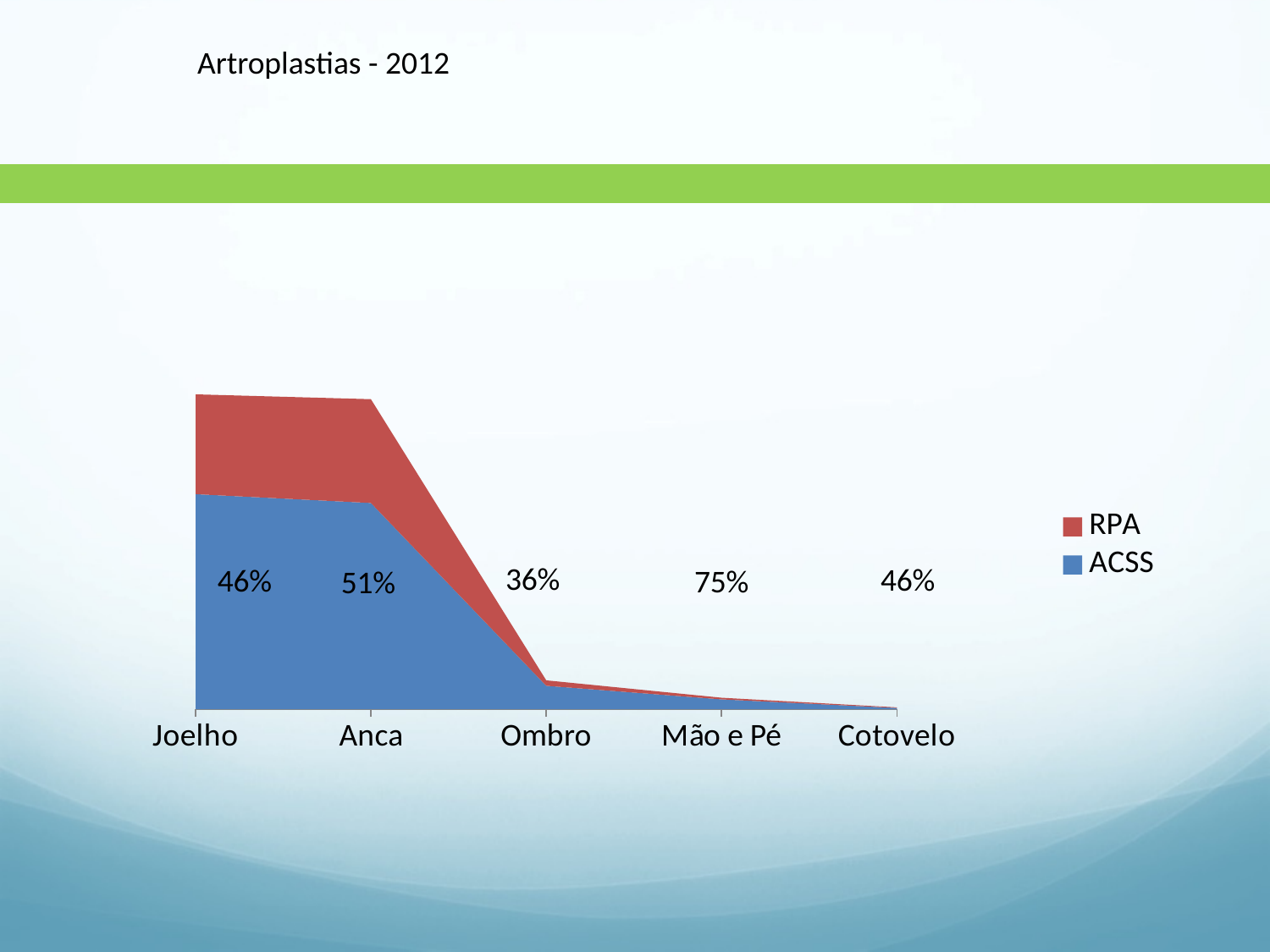
What percentage label is printed at the Ombro category? 36% How many series does the legend list? 2 Which category has the lowest stacked total? Cotovelo What percentage label is printed at the Joelho category? 46% What percentage label is printed at the Cotovelo category? 46% What percentage label is printed at the Mão e Pé category? 75% How many categories are shown on the x axis? 5 What type of chart is shown on the slide? Area chart What is the title of the chart? Artroplastias - 2012 What percentage label is printed at the Anca category? 51% Which has a larger ACSS value, Anca or Ombro? Anca Which series is shown in red? RPA